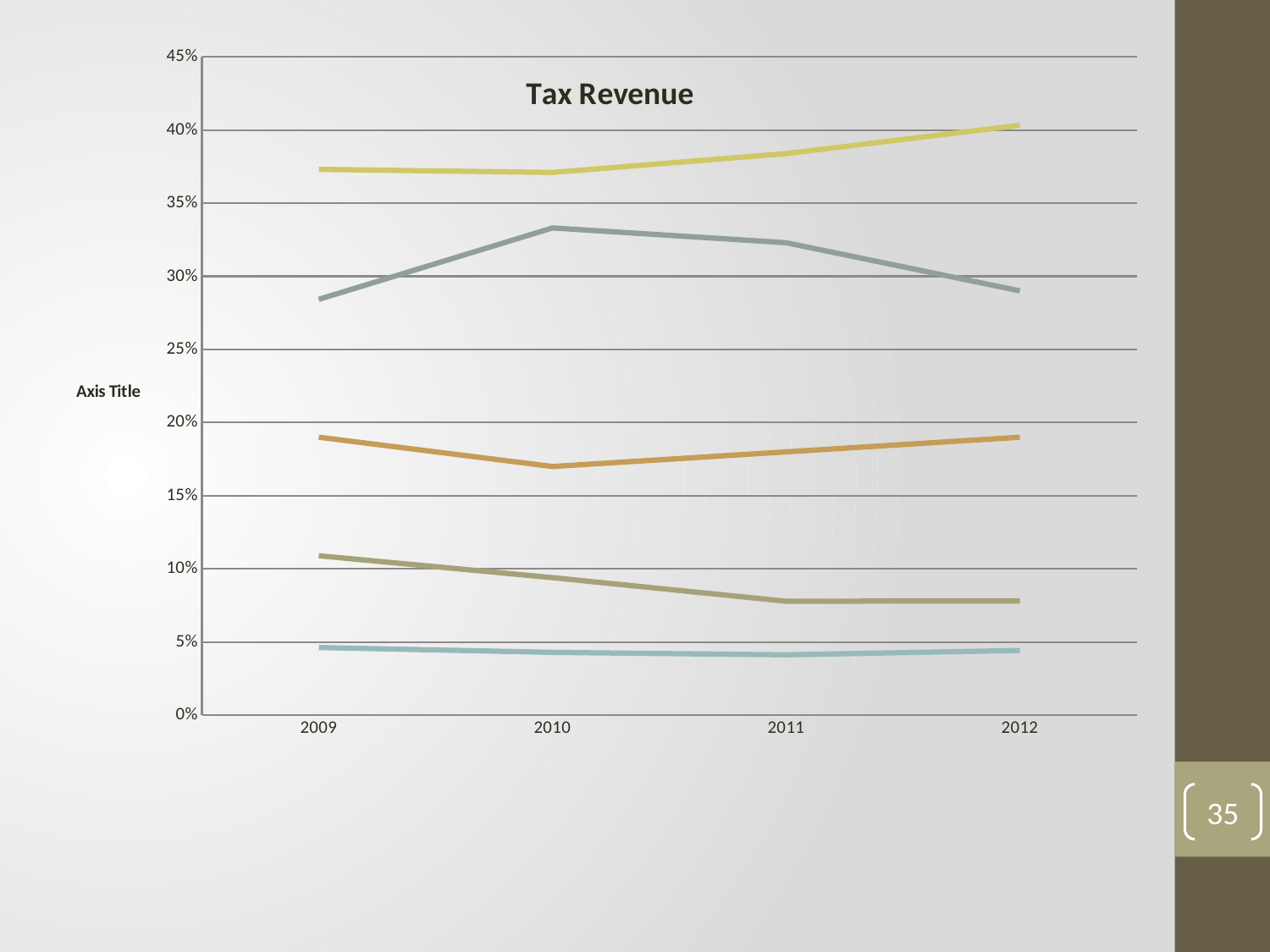
What kind of chart is shown on the slide? line chart What is the title of the chart? Tax Revenue Which line is the highest in 2012? the yellow line How many years are shown on the x axis of the chart? 4 Which line is the lowest in 2009? the light blue line Is the value of the orange line in 2010 greater or less than 20%? less What text is shown as the vertical axis title? Axis Title Is the value of the yellow line in 2009 greater or less than 35%? greater Is the value of the grey-green line in 2010 greater or less than 30%? greater How many lines are plotted on the chart? 5 Does the olive line rise or fall from 2009 to 2012? fall